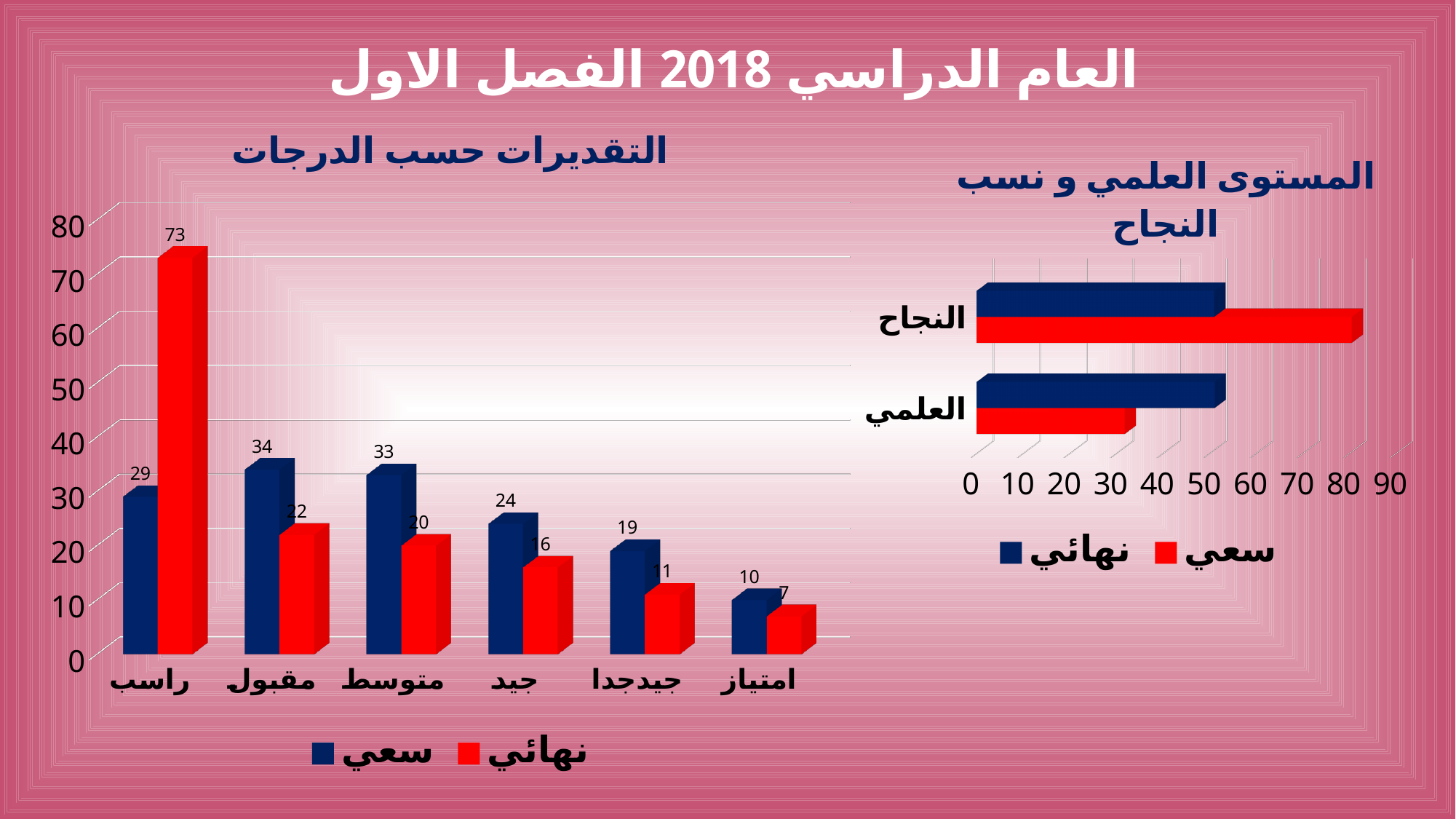
In the chart titled التقديرات حسب الدرجات, which category has the lowest سعي value? امتياز What kind of chart is the chart on the right of the slide, titled المستوى العلمي و نسب النجاح? bar chart In the chart titled التقديرات حسب الدرجات, what is the value of سعي for مقبول? 34 In the chart titled المستوى العلمي و نسب النجاح, is the value of سعي for النجاح greater or less than 70? greater In the chart titled التقديرات حسب الدرجات, which category has the highest نهائي value? راسب In the chart titled التقديرات حسب الدرجات, what is the value of نهائي for جيد? 16 In the chart titled المستوى العلمي و نسب النجاح, is the value of سعي for العلمي greater or less than 40? less In the chart titled التقديرات حسب الدرجات, what is the value of نهائي for راسب? 73 How many series does the legend of the chart titled التقديرات حسب الدرجات list? 2 In the chart titled التقديرات حسب الدرجات, which is larger for متوسط: سعي or نهائي? سعي In the chart titled التقديرات حسب الدرجات, what is the difference between the نهائي and سعي values for راسب? 44 How many categories are shown on the x axis of the chart titled التقديرات حسب الدرجات? 6